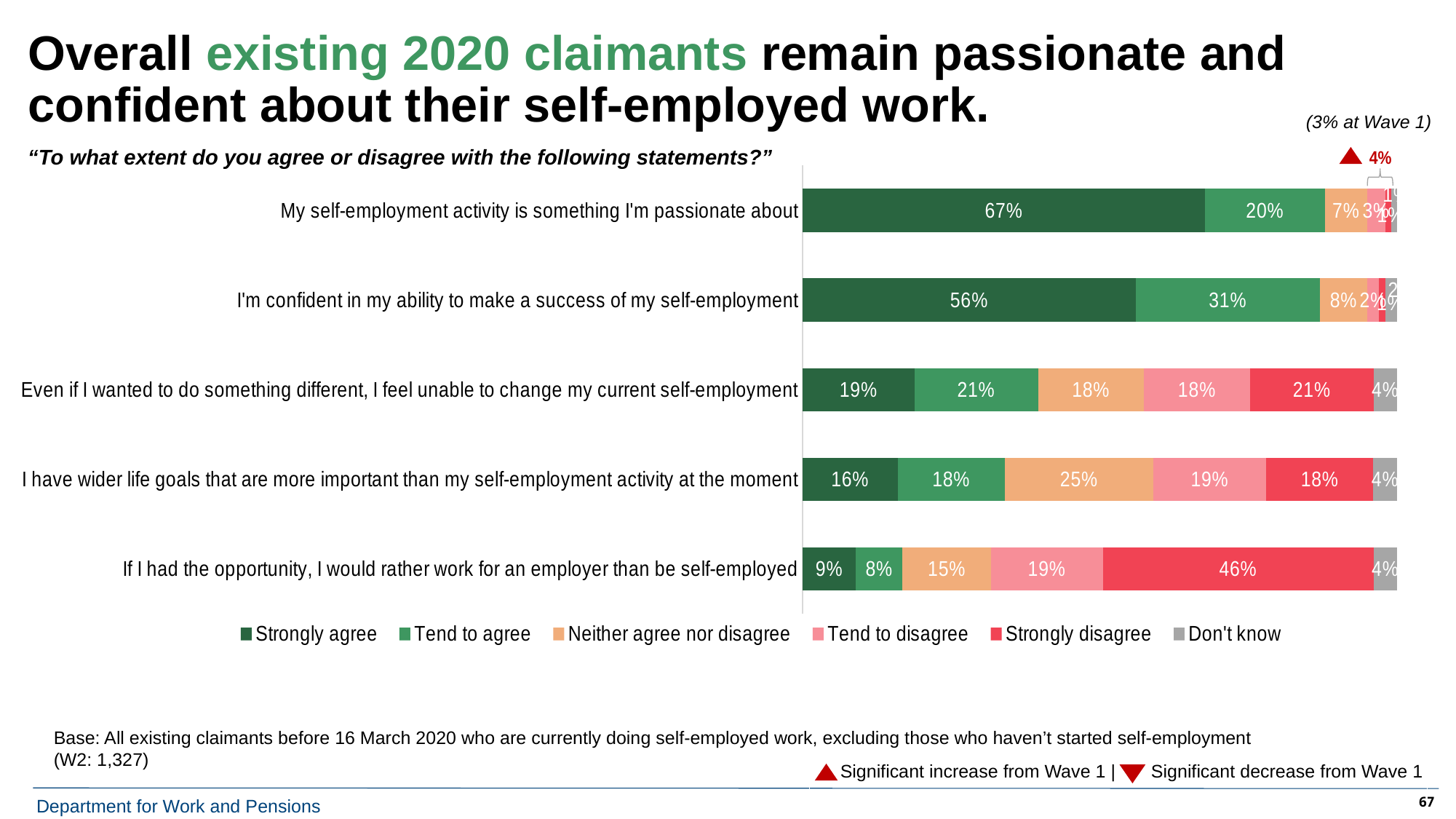
How many statements are shown in the chart? 5 What is the total of the stacked bar for "I have wider life goals that are more important than my self-employment activity at the moment"? 100% What is the "Neither agree nor disagree" value for "I have wider life goals that are more important than my self-employment activity at the moment"? 25% What kind of chart is shown on the slide? Stacked bar chart What percentage strongly disagree with "If I had the opportunity, I would rather work for an employer than be self-employed"? 46% Which has a larger "Strongly disagree" share: "Even if I wanted to do something different, I feel unable to change my current self-employment" or "I have wider life goals that are more important than my self-employment activity at the moment"? Even if I wanted to do something different, I feel unable to change my current self-employment Which statement has the highest "Strongly agree" percentage? My self-employment activity is something I'm passionate about What is the difference in "Strongly agree" percentage between the passionate statement (67%) and the confident statement (56%)? 11 percentage points How many response categories does the legend list? 6 What percentage tend to agree with "I'm confident in my ability to make a success of my self-employment"? 31% What percentage strongly agree with the statement "My self-employment activity is something I'm passionate about"? 67% Which statement has the lowest "Strongly agree" percentage? If I had the opportunity, I would rather work for an employer than be self-employed